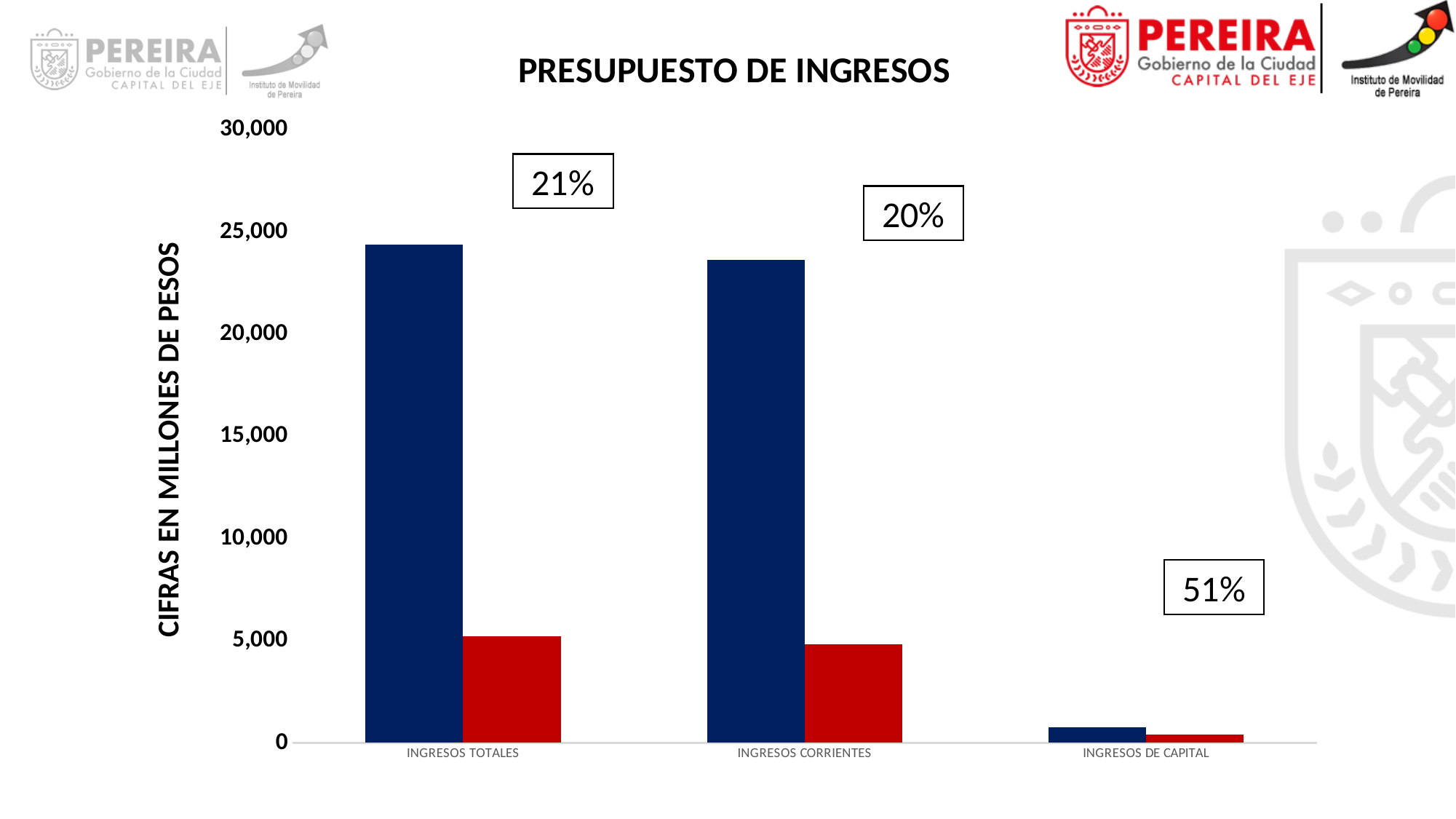
What percentage label is shown above the INGRESOS CORRIENTES bars? 20% What is the title of the chart? PRESUPUESTO DE INGRESOS What percentage label is shown above the INGRESOS DE CAPITAL bars? 51% For INGRESOS CORRIENTES, which bar is larger, the dark blue one or the red one? the dark blue one How many categories are shown on the x axis of the chart? 3 Is the dark blue bar for INGRESOS CORRIENTES greater or less than 20,000? greater Which category has the tallest dark blue bar? INGRESOS TOTALES What type of chart is shown on the slide? bar chart Is the dark blue bar for INGRESOS TOTALES greater or less than 25,000? less What is the label on the vertical axis of the chart? CIFRAS EN MILLONES DE PESOS What percentage label is shown above the INGRESOS TOTALES bars? 21% Which category has the shortest dark blue bar? INGRESOS DE CAPITAL